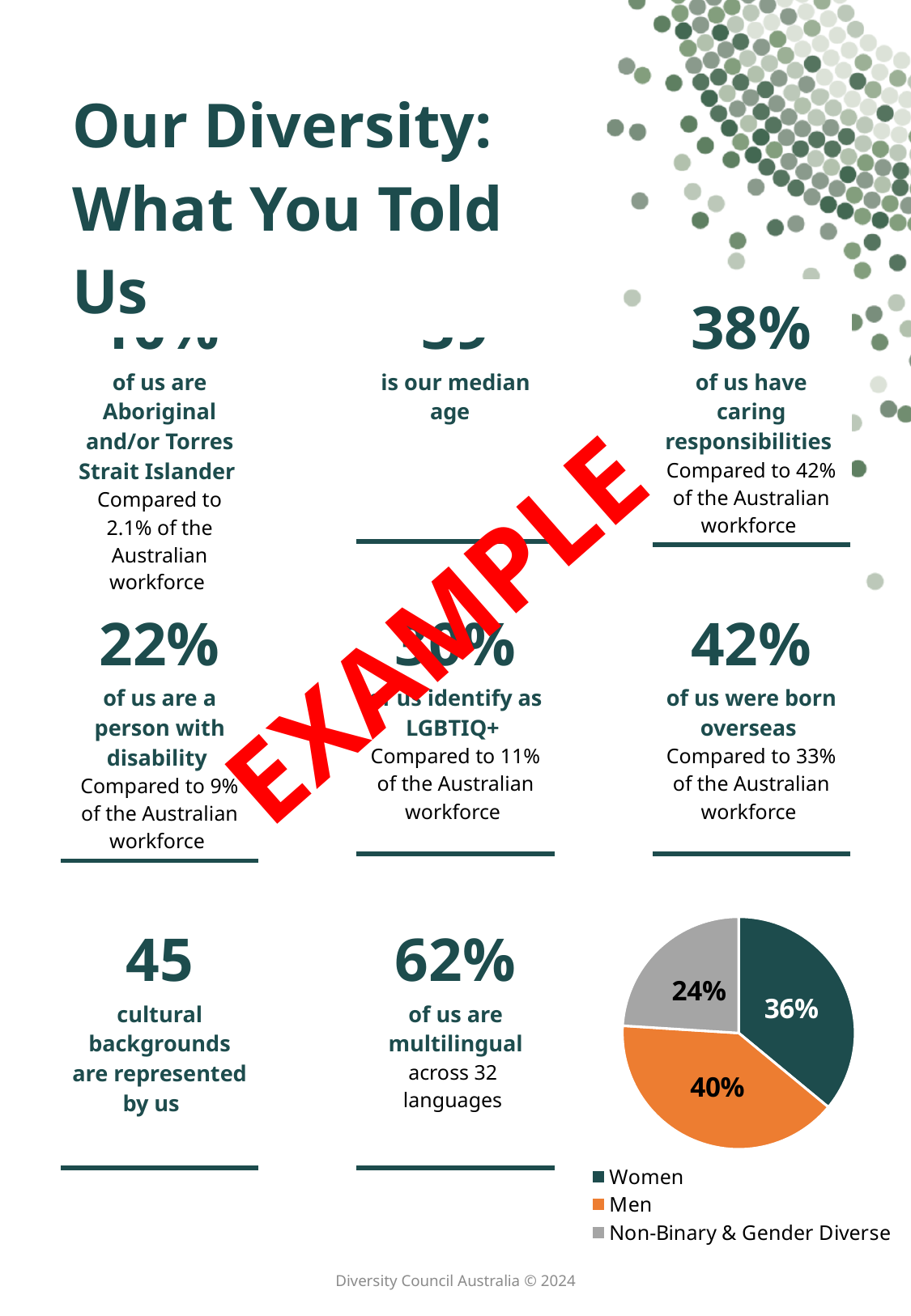
Which slice of the pie chart is the smallest? Non-Binary & Gender Diverse In the pie chart, which is larger, the share for Women or the share for Non-Binary & Gender Diverse? Women In the pie chart, what share is shown for Men? 40% Which slice of the pie chart is the largest? Men In the pie chart, what share is shown for Non-Binary & Gender Diverse? 24% In the pie chart, what is the difference in percentage points between Women and Non-Binary & Gender Diverse? 12 In the pie chart, what share is shown for Women? 36% In the pie chart, what is the difference in percentage points between Men and Women? 4 How many entries does the pie chart's legend list? 3 What kind of chart is shown at the bottom right of the slide? pie chart How many slices does the pie chart have? 3 What colour is the Men slice in the pie chart? orange